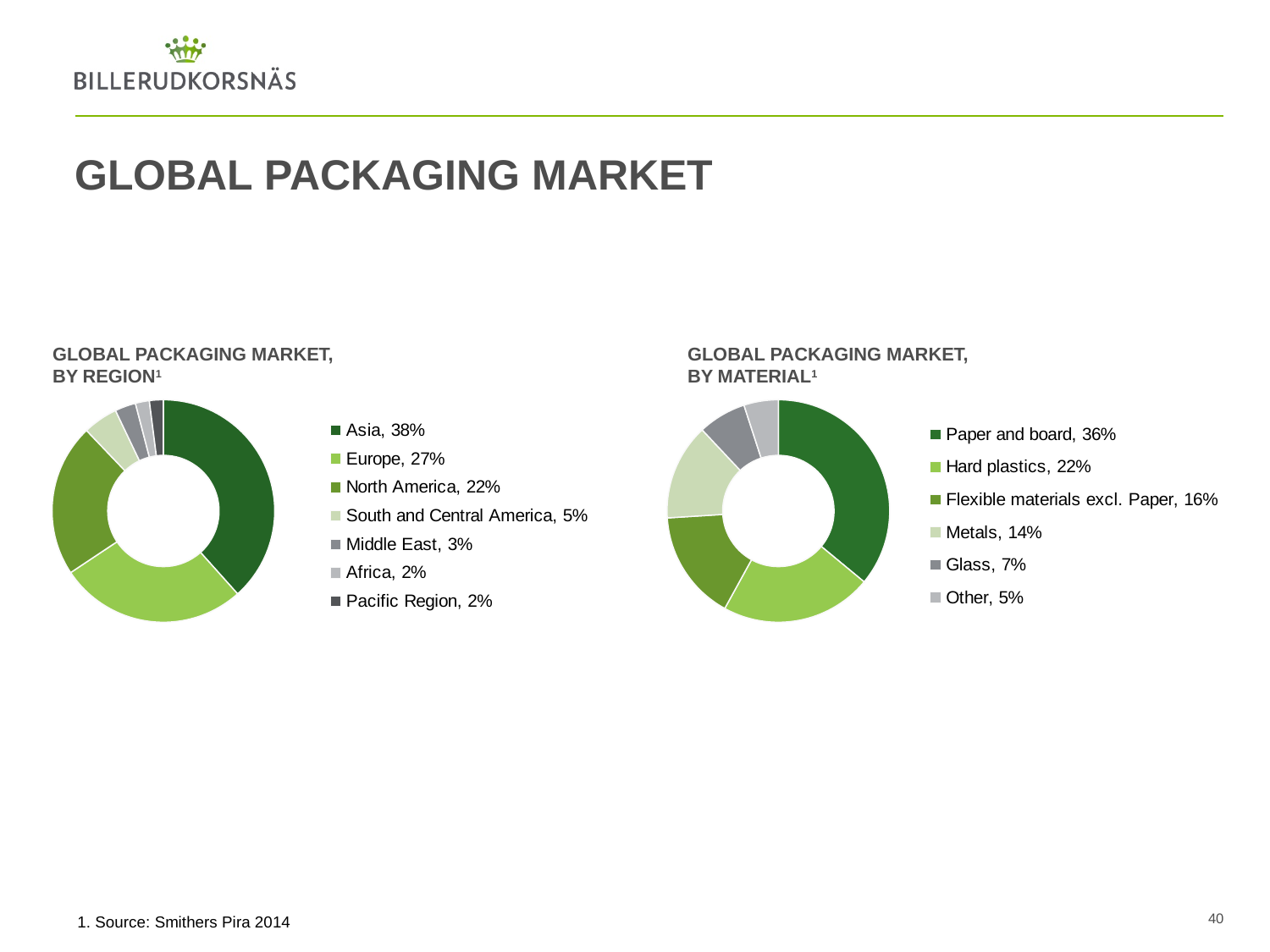
In the 'Global packaging market, by region' chart, how many regions are shown? 7 In the 'Global packaging market, by region' chart, what is the difference between Europe's share and North America's share? 5% In the 'Global packaging market, by material' chart, what is the difference between the shares of Paper and board and Flexible materials excl. Paper? 20% What type of chart is used for the 'Global packaging market, by material' data? Doughnut (pie) chart In the 'Global packaging market, by region' chart, what share does Asia hold? 38% In the 'Global packaging market, by region' chart, what share does the Middle East hold? 3% In the 'Global packaging market, by material' chart, how many material categories are listed? 6 In the 'Global packaging market, by region' chart, which region has the largest share? Asia In the 'Global packaging market, by material' chart, which is larger: Hard plastics or Metals? Hard plastics In the 'Global packaging market, by material' chart, which material has the smallest share? Other In the 'Global packaging market, by material' chart, what share does Paper and board hold? 36% What source is cited for the charts on the slide? Smithers Pira 2014